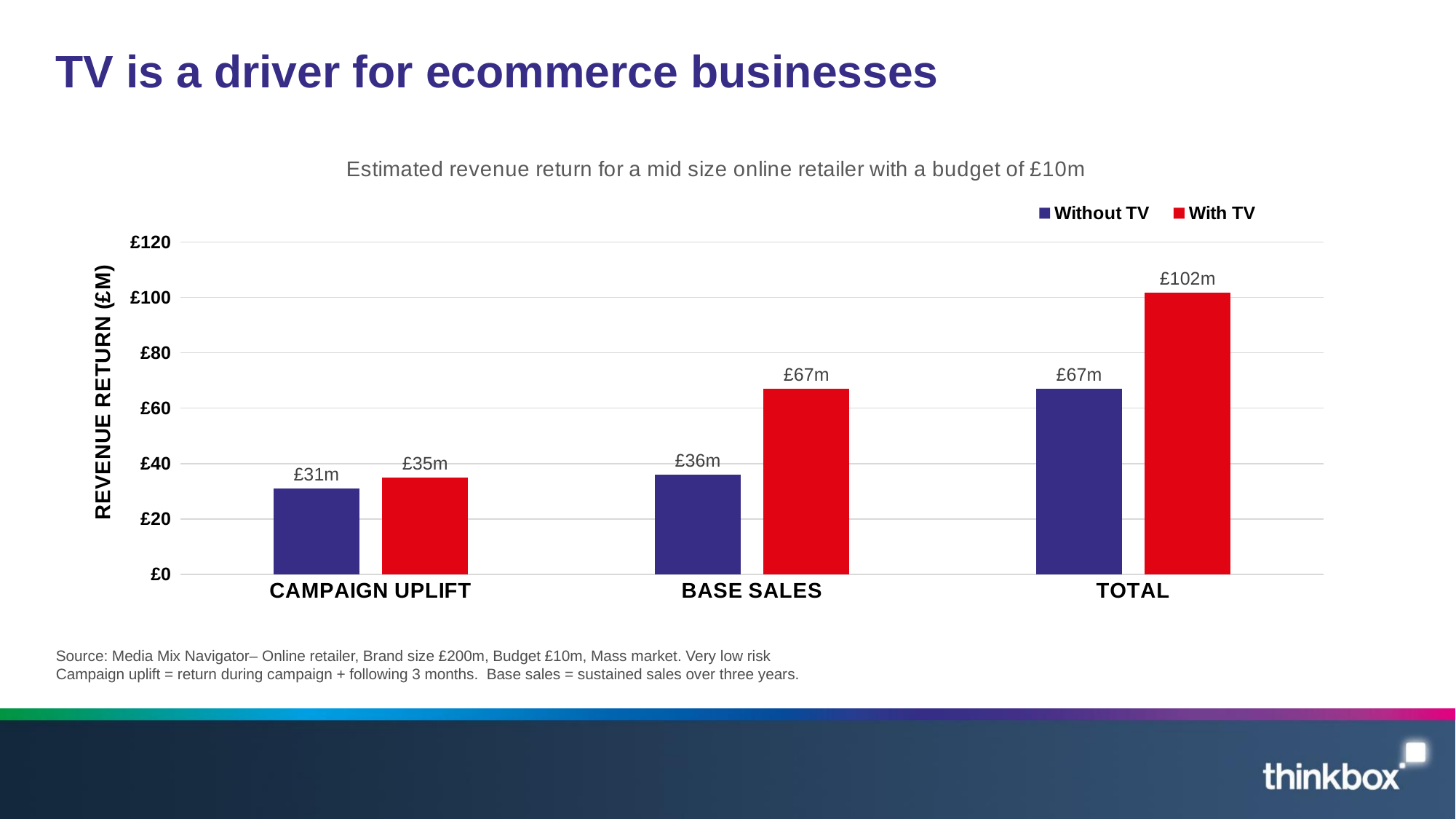
What is the Total revenue return without TV? £67m How many categories are shown on the x axis? 3 Which category has the lowest value for the Without TV series? Campaign Uplift What is the difference between the With TV and Without TV values for Base Sales? £31m What is the revenue return for Campaign Uplift without TV? £31m What is the revenue return for Base Sales with TV? £67m Which category has the highest value for the With TV series? Total What is the Total revenue return with TV? £102m What is the difference between the With TV and Without TV values for Total? £35m What type of chart is shown on the slide? Bar chart Which is larger for Campaign Uplift: the With TV value or the Without TV value? With TV How many series does the legend list? 2